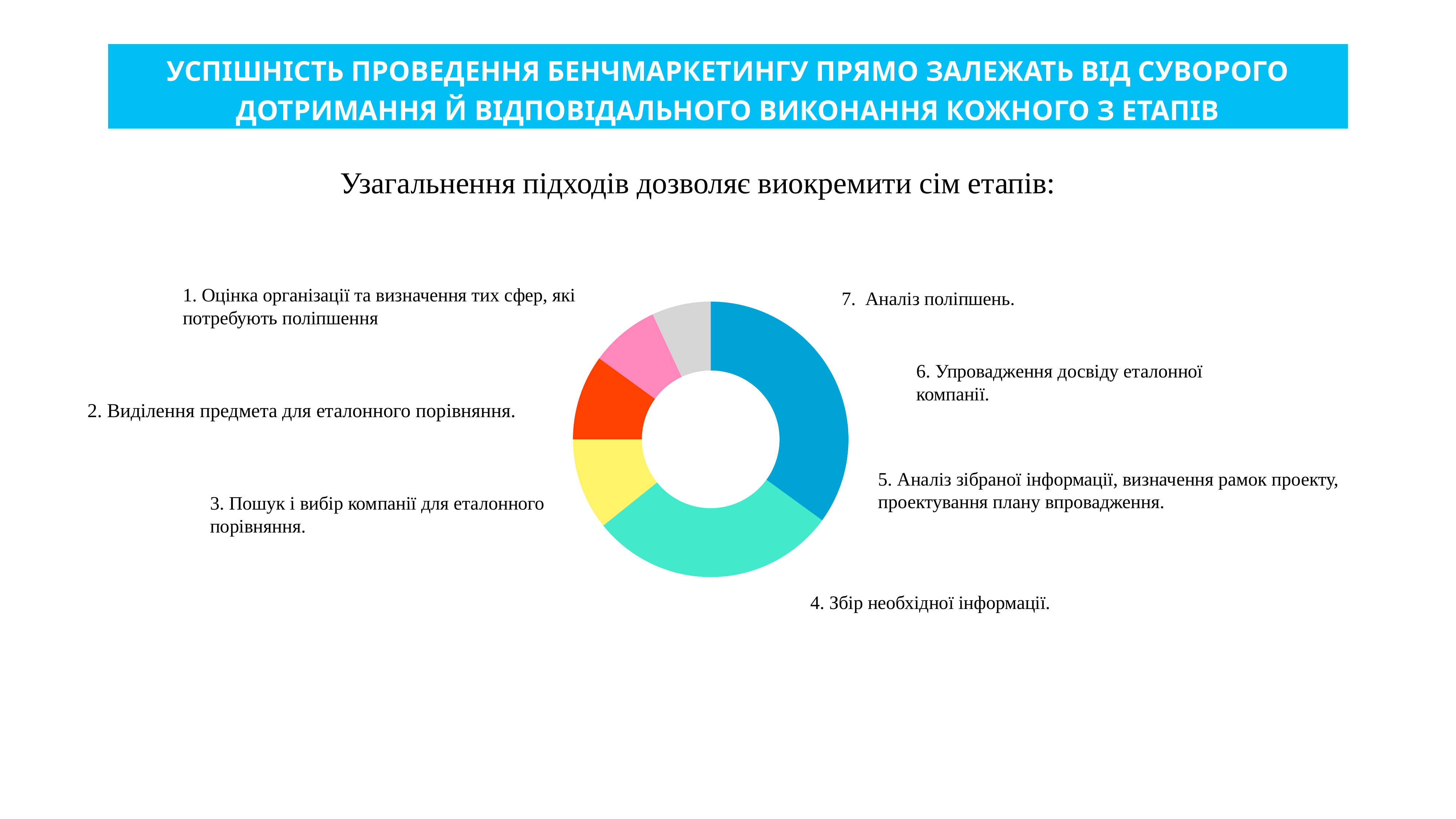
Does the doughnut chart have a legend? No Which is larger in the doughnut chart, the teal slice or the grey slice? Teal What kind of chart is shown on the slide? Doughnut (pie) chart How many slices does the doughnut chart have? 6 Which is larger in the doughnut chart, the blue slice or the yellow slice? Blue Which is larger in the doughnut chart, the teal slice or the red-orange slice? Teal Does the doughnut chart display data labels with values? No Which colour slice is the largest in the doughnut chart? Blue